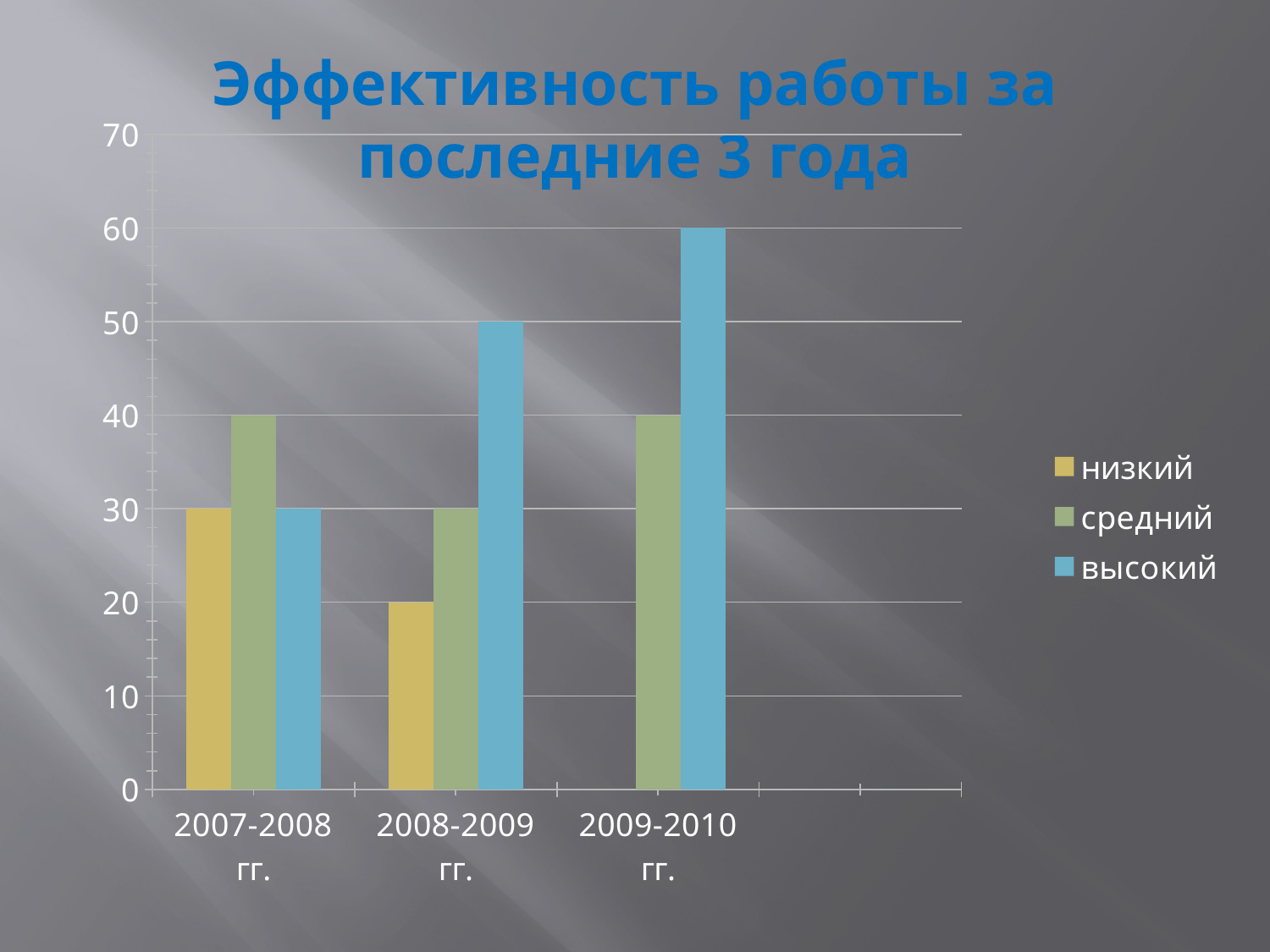
What kind of chart is shown on the slide? bar chart What is the value of the высокий series for 2009-2010 гг.? 60 In which period is the низкий series lowest among the periods where it is shown? 2008-2009 гг. What is the value of the низкий series for 2008-2009 гг.? 20 Which is larger for 2008-2009 гг.: the средний value or the высокий value? высокий In which period does the высокий series reach its highest value? 2009-2010 гг. What is the value of the средний series for 2007-2008 гг.? 40 How many series does the legend list? 3 What is the title of the chart? Эффективность работы за последние 3 года Does the высокий series rise or fall from 2007-2008 гг. to 2009-2010 гг.? rise What is the difference between the высокий values for 2009-2010 гг. and 2007-2008 гг.? 30 How many periods are shown on the x axis? 3